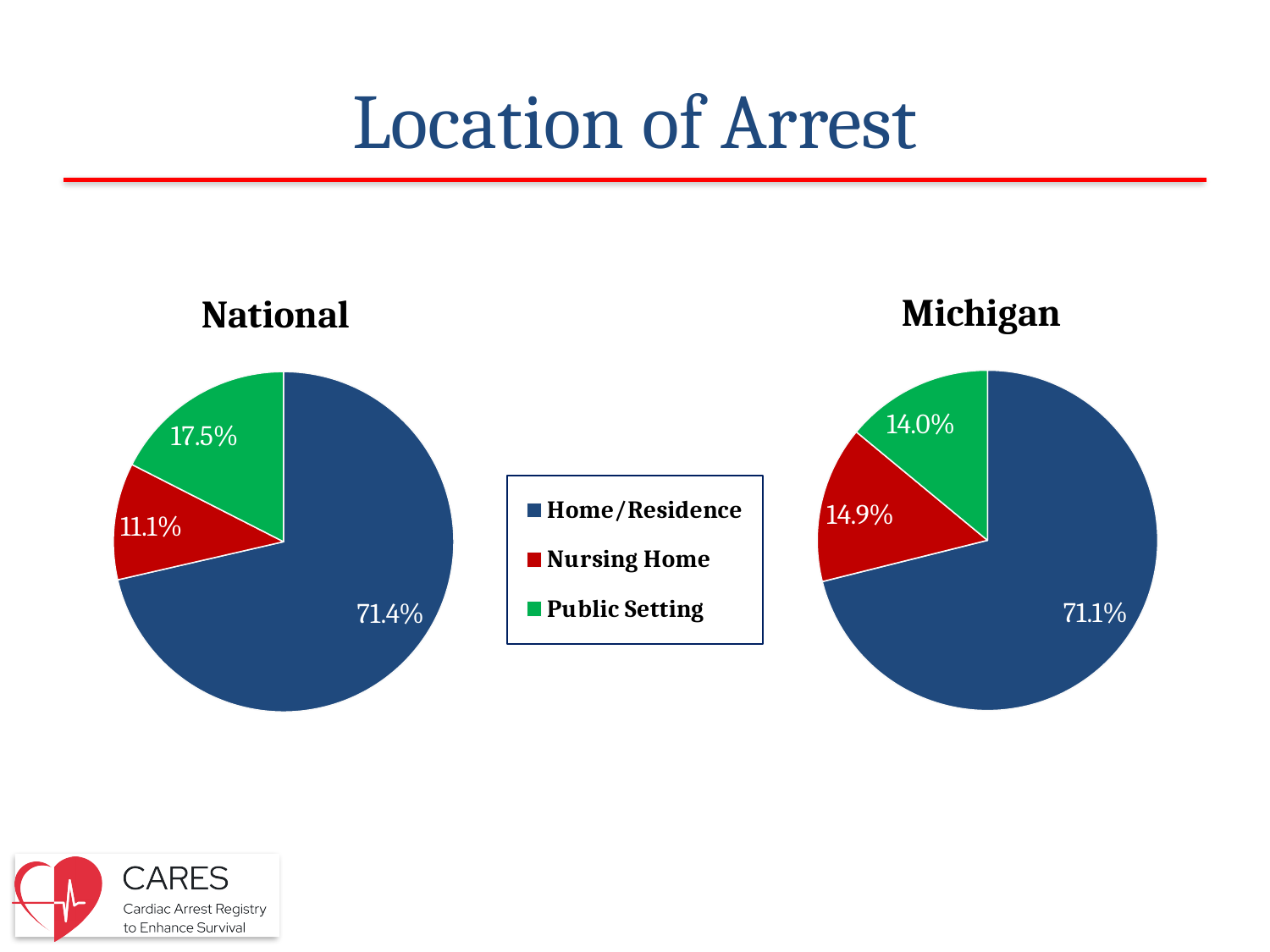
In the Michigan pie chart, which location has the smallest share? Public Setting In the National pie chart, what percentage of arrests occurred at Home/Residence? 71.4% What is the difference between the Public Setting share in the National chart and the Public Setting share in the Michigan chart? 3.5% What type of chart is used to show the National data? Pie chart How many slices does the Michigan pie chart have? 3 How many entries does the legend list? 3 In the National pie chart, which location has the smallest share? Nursing Home Which is larger: the Nursing Home share in the National chart or the Nursing Home share in the Michigan chart? Michigan In the Michigan pie chart, what percentage of arrests occurred in a Nursing Home? 14.9% In the National pie chart, which location has the largest share? Home/Residence In the Michigan pie chart, what percentage of arrests occurred in a Public Setting? 14.0% In the National pie chart, what percentage of arrests occurred in a Public Setting? 17.5%